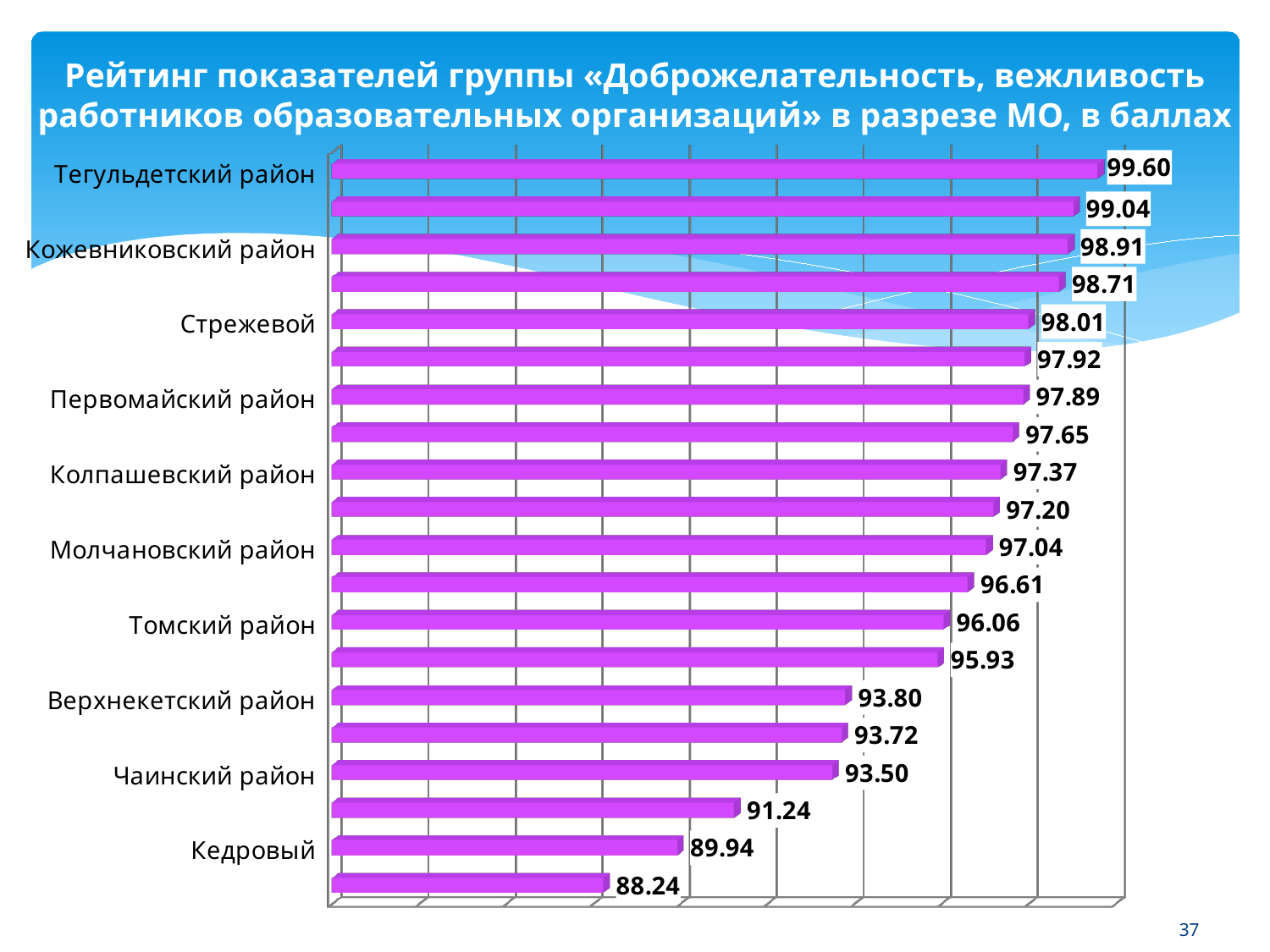
What is the value for Тегульдетский район? 99.60 What is the value for Кедровый? 89.94 Which labelled category has the lowest value? Кедровый How many bars are plotted in the chart? 20 Which is larger, the value for Первомайский район or the value for Колпашевский район? Первомайский район Which labelled category has the highest value? Тегульдетский район What kind of chart is shown on the slide? bar chart What is the value for Стрежевой? 98.01 What is the difference between the values for Тегульдетский район and Кедровый? 9.66 What is the value for Кожевниковский район? 98.91 What colour are the bars in the chart? purple What is the value for Томский район? 96.06